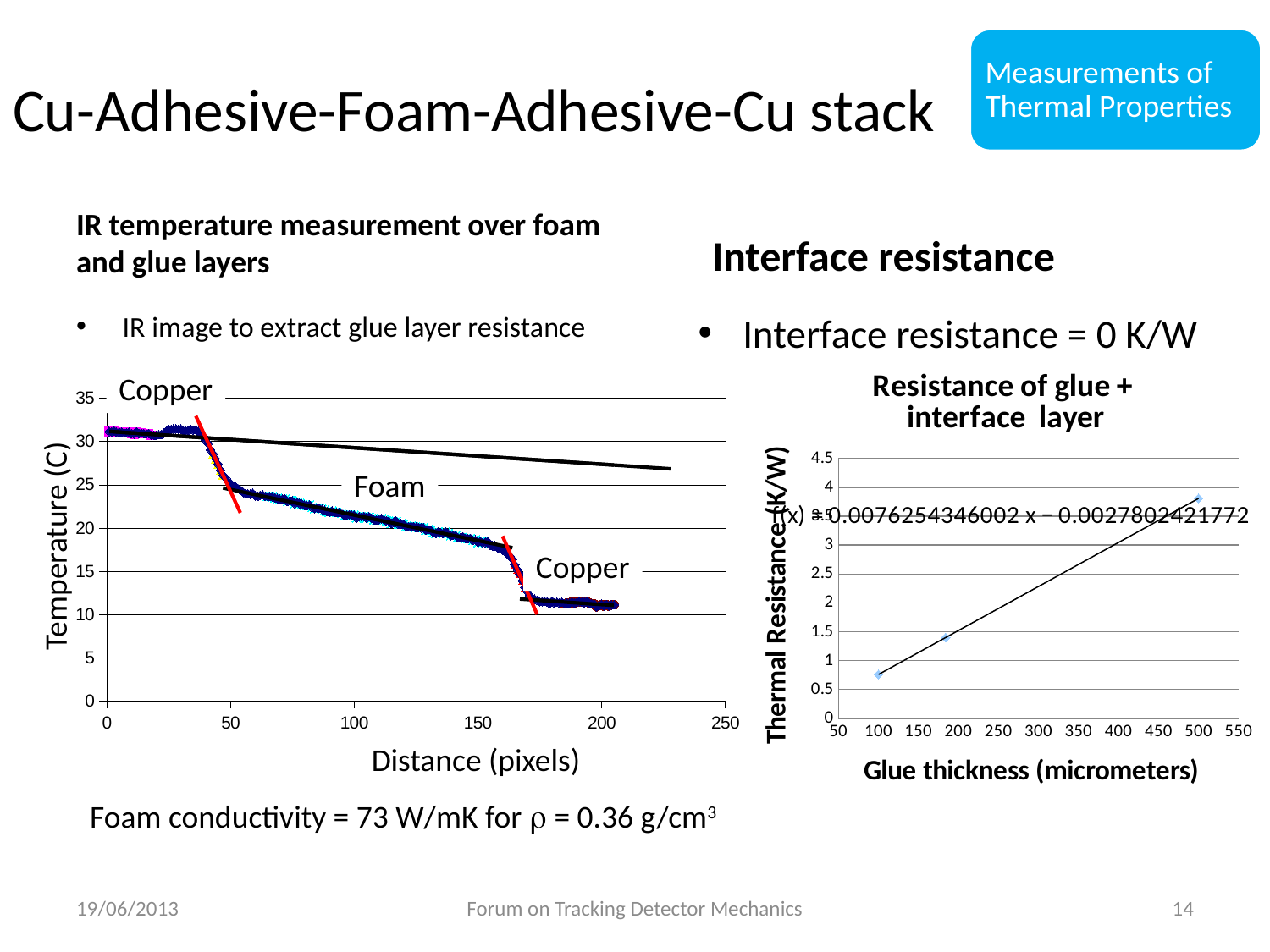
In the temperature versus distance chart on the left, is the temperature at a distance of 0 pixels greater or less than 30 C? greater In the temperature versus distance chart on the left, do the temperature values rise or fall as distance increases? fall In the temperature versus distance chart on the left, is the temperature at a distance of 100 pixels greater or less than 25 C? less In the 'Resistance of glue + interface layer' chart, is the thermal resistance at a glue thickness of 100 micrometers greater or less than 1 K/W? less In the 'Resistance of glue + interface layer' chart, do the thermal resistance values rise or fall as glue thickness increases? rise In the 'Resistance of glue + interface layer' chart, how many data points are plotted? 3 In the 'Resistance of glue + interface layer' chart, which glue thickness has the highest thermal resistance? 500 micrometers In the 'Resistance of glue + interface layer' chart, what trendline equation is shown? f(x) = 0.0076254346002 x − 0.0027802421772 In the 'Resistance of glue + interface layer' chart, what is the label of the x axis? Glue thickness (micrometers) What kind of chart is the 'Resistance of glue + interface layer' chart? scatter chart